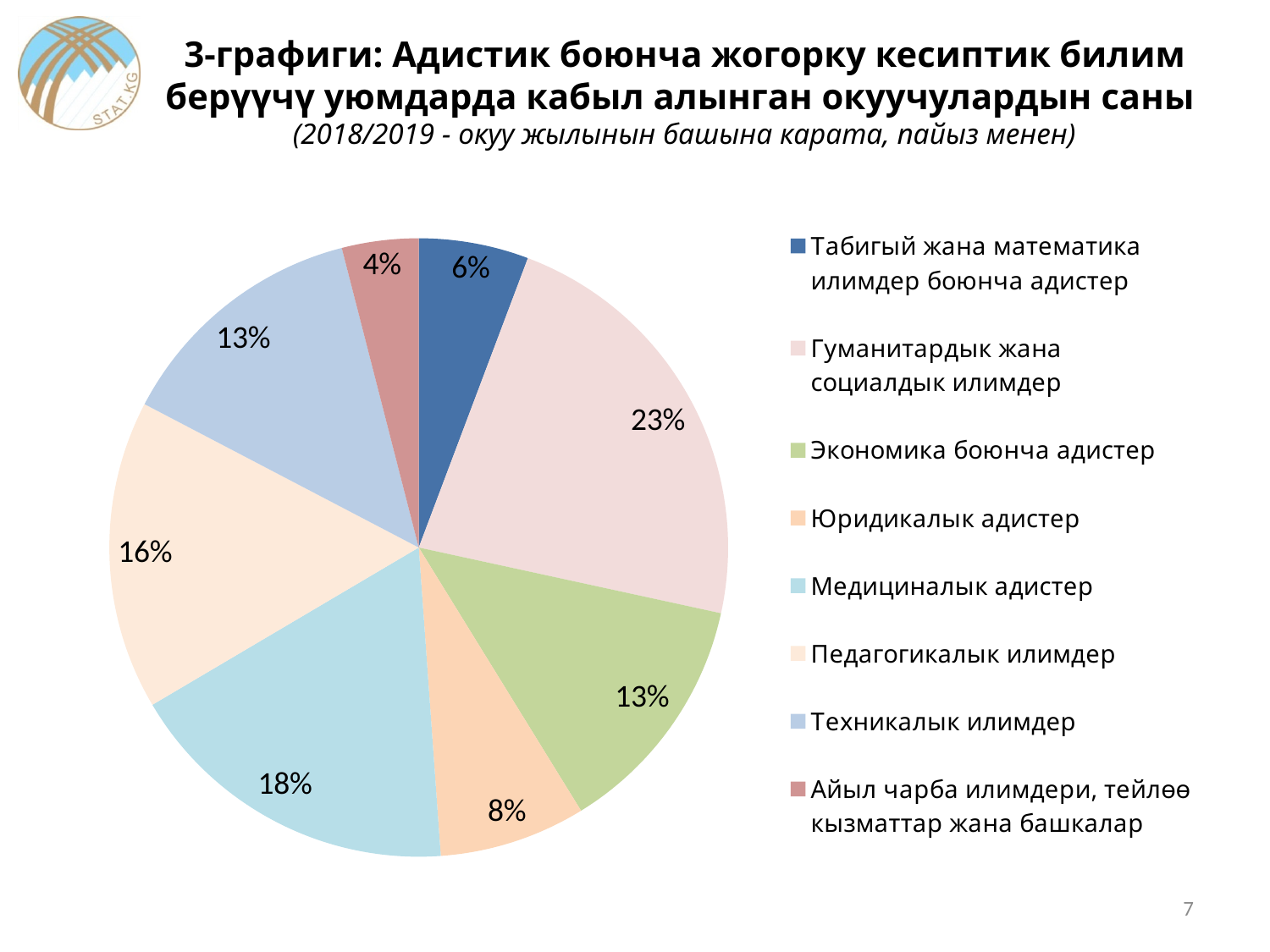
What is the value shown for Педагогикалык илимдер? 16% What type of chart is shown on the slide? Pie chart Which category has the smallest share of the pie? Айыл чарба илимдери, тейлөө кызматтар жана башкалар What is the combined share of Экономика боюнча адистер and Техникалык илимдер? 26% Which is larger, the share for Педагогикалык илимдер or the share for Экономика боюнча адистер? Педагогикалык илимдер What is the value shown for Юридикалык адистер? 8% What is the difference in percentage points between Медициналык адистер and Юридикалык адистер? 10 How many categories does the legend list? 8 Which category has the largest share of the pie? Гуманитардык жана социалдык илимдер What is the value shown for Табигый жана математика илимдер боюнча адистер? 6% What is the value shown for Медициналык адистер? 18% What share of the pie is labelled for Гуманитардык жана социалдык илимдер? 23%